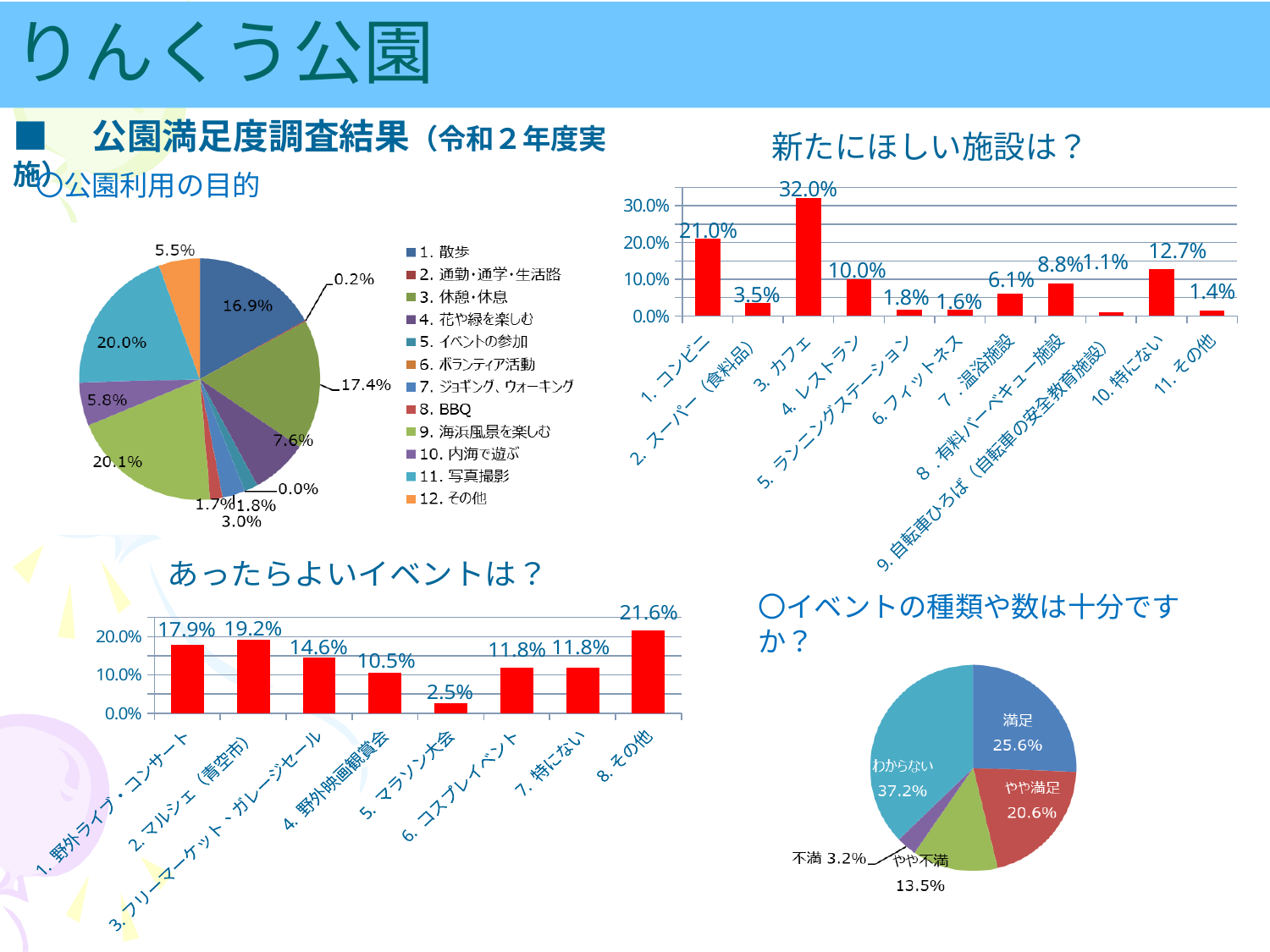
In the chart titled あったらよいイベントは？, what kind of chart is used? bar chart In the chart titled あったらよいイベントは？, which is larger, 1. 野外ライブ・コンサート or 8. その他? 8. その他 In the chart titled 新たにほしい施設は？, which category has the highest value? 3. カフェ In the pie chart titled 〇公園利用の目的, what is the value for 1. 散歩? 16.9% In the chart titled あったらよいイベントは？, what is the value for 2. マルシェ（青空市）? 19.2% In the pie chart titled 〇イベントの種類や数は十分ですか？, what share does わからない have? 37.2% In the pie chart titled 〇イベントの種類や数は十分ですか？, which slice is the smallest? 不満 In the chart titled 新たにほしい施設は？, what is the value for 3. カフェ? 32.0% In the chart titled あったらよいイベントは？, which category has the lowest value? 5. マラソン大会 In the chart titled 新たにほしい施設は？, how many categories are shown? 11 In the chart titled 新たにほしい施設は？, what is the difference between 1. コンビニ and 4. レストラン? 11.0% In the pie chart titled 〇公園利用の目的, how many entries does the legend list? 12